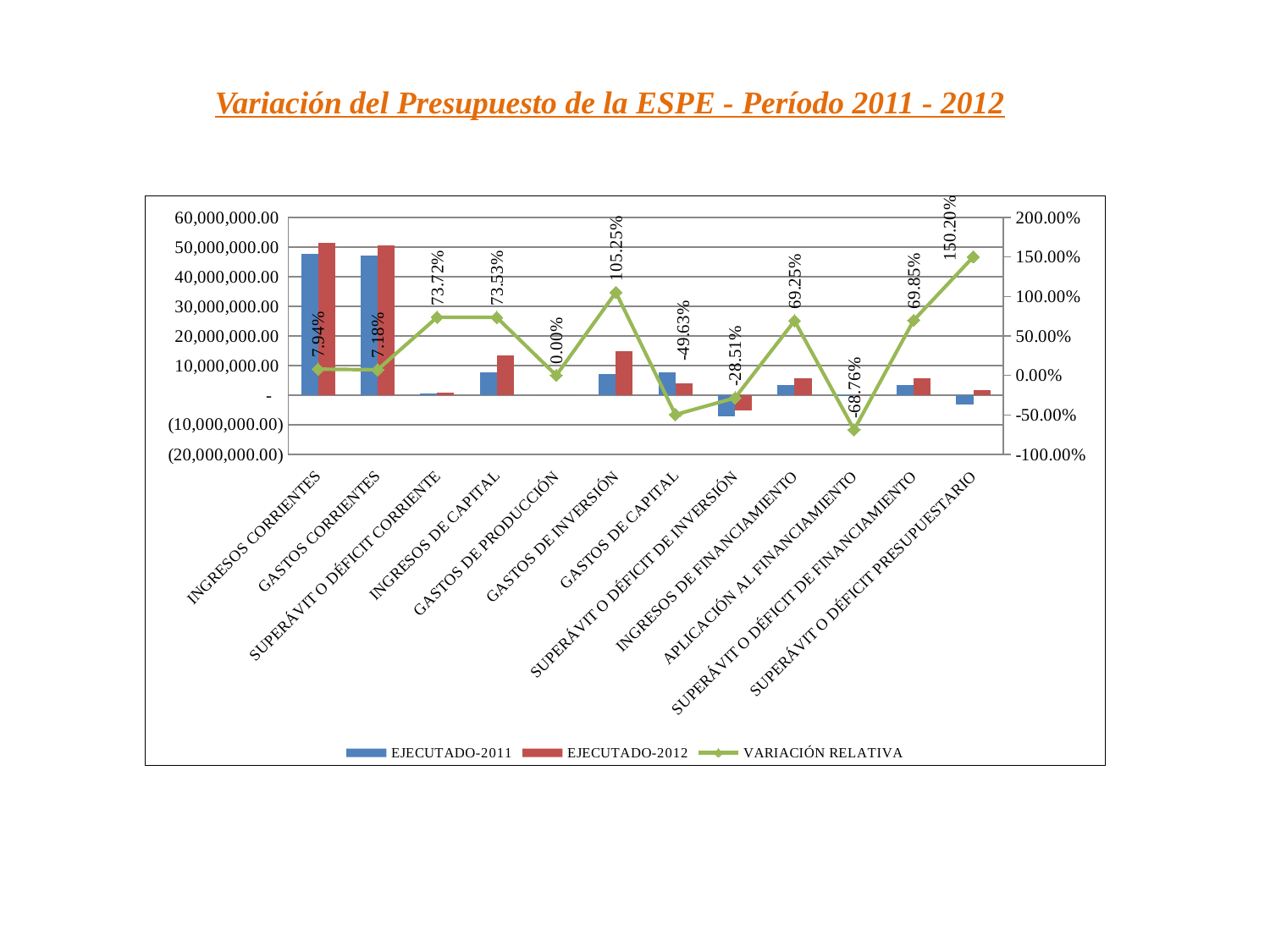
Is the EJECUTADO-2012 value for INGRESOS CORRIENTES greater or less than 40,000,000.00? greater Which category has the lowest VARIACIÓN RELATIVA? APLICACIÓN AL FINANCIAMIENTO Is the EJECUTADO-2011 value for INGRESOS DE CAPITAL greater or less than 20,000,000.00? less How many categories are shown on the x axis? 12 How many series does the legend list? 3 What is the VARIACIÓN RELATIVA value for INGRESOS CORRIENTES? 7.94% What kind of chart is shown on the slide? Combination bar and line chart What is the difference between the VARIACIÓN RELATIVA for SUPERÁVIT O DÉFICIT PRESUPUESTARIO and for GASTOS DE INVERSIÓN? 44.95% What is the VARIACIÓN RELATIVA value for APLICACIÓN AL FINANCIAMIENTO? -68.76% What is the VARIACIÓN RELATIVA value for GASTOS DE INVERSIÓN? 105.25% Which category has the highest VARIACIÓN RELATIVA? SUPERÁVIT O DÉFICIT PRESUPUESTARIO Which has a larger VARIACIÓN RELATIVA, SUPERÁVIT O DÉFICIT CORRIENTE or INGRESOS DE FINANCIAMIENTO? SUPERÁVIT O DÉFICIT CORRIENTE